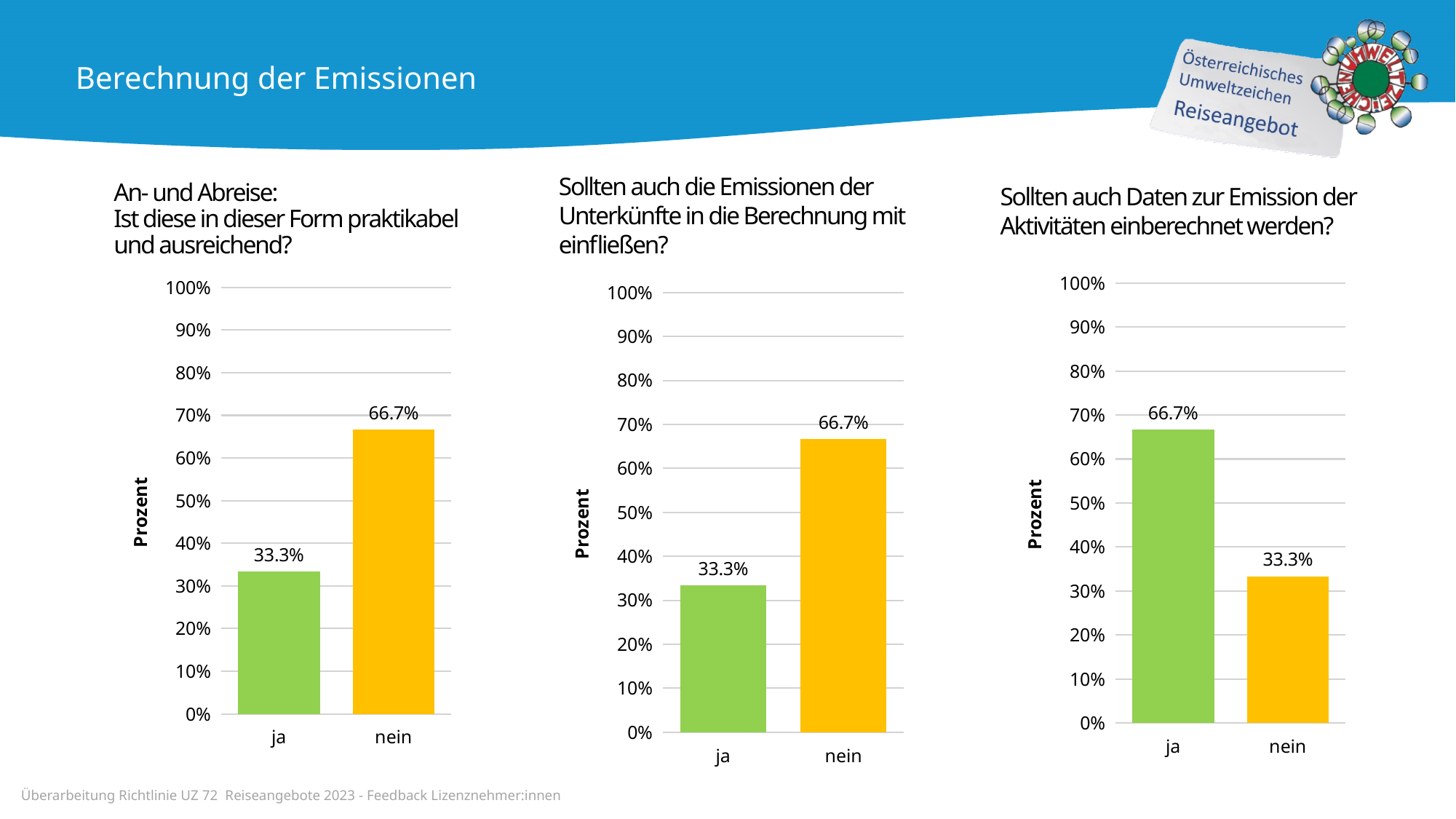
In the middle chart (Sollten auch die Emissionen der Unterkünfte in die Berechnung mit einfließen?), what is the value for "ja"? 33.3% What kind of chart is the middle chart (Emissionen der Unterkünfte)? bar chart How many categories does the left chart (An- und Abreise) show? 2 In the right chart (Sollten auch Daten zur Emission der Aktivitäten einberechnet werden?), which category has the highest value? ja In the left chart (An- und Abreise: Ist diese in dieser Form praktikabel und ausreichend?), what is the value for "nein"? 66.7% What is the y-axis label of the right chart (Emission der Aktivitäten)? Prozent In the middle chart (Emissionen der Unterkünfte), which category has the lowest value? ja In the left chart (An- und Abreise), what is the value for "ja"? 33.3% In the right chart (Sollten auch Daten zur Emission der Aktivitäten einberechnet werden?), what is the value for "ja"? 66.7% In the middle chart (Emissionen der Unterkünfte), which is larger, the value for "ja" or the value for "nein"? nein In the right chart (Emission der Aktivitäten), is the value for "nein" greater or less than 40%? less In the left chart (An- und Abreise), what is the difference between the values for "nein" and "ja"? 33.4%